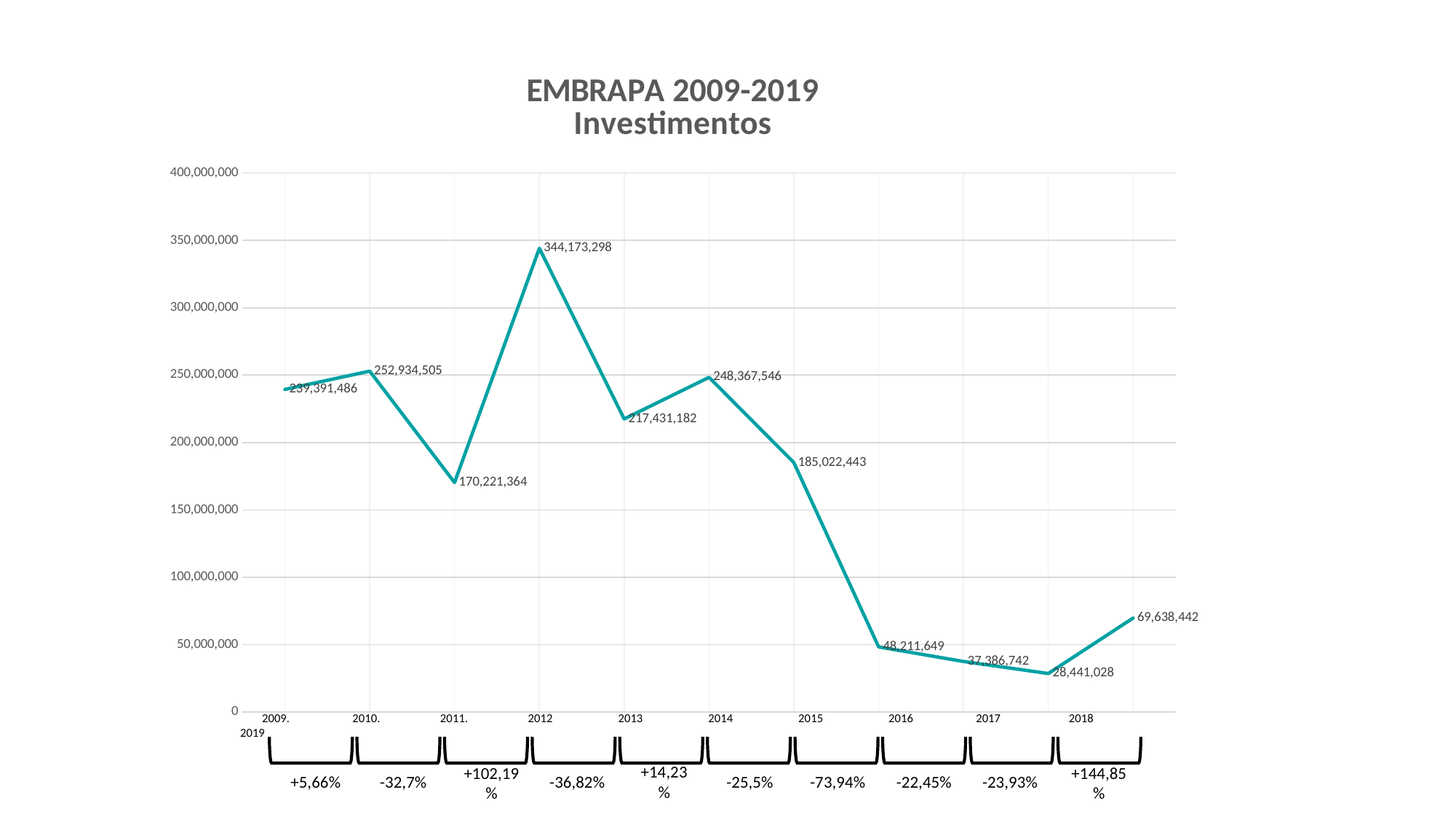
What is the investment value for 2018? 28,441,028 What is the investment value for 2015? 185,022,443 What is the investment value for 2012? 344,173,298 Which is larger, the investment value for 2010 or for 2014? 2010 Which year has the highest investment value? 2012 What type of chart is shown on the slide? Line chart Which year has the lowest investment value? 2018 How many data points are plotted on the line? 11 What is the title of the chart? EMBRAPA 2009-2019 Investimentos What is the difference between the investment values for 2019 and 2018? 41,197,414 What is the difference between the investment values for 2012 and 2011? 173,951,934 Is the investment value for 2016 greater or less than 50,000,000? less